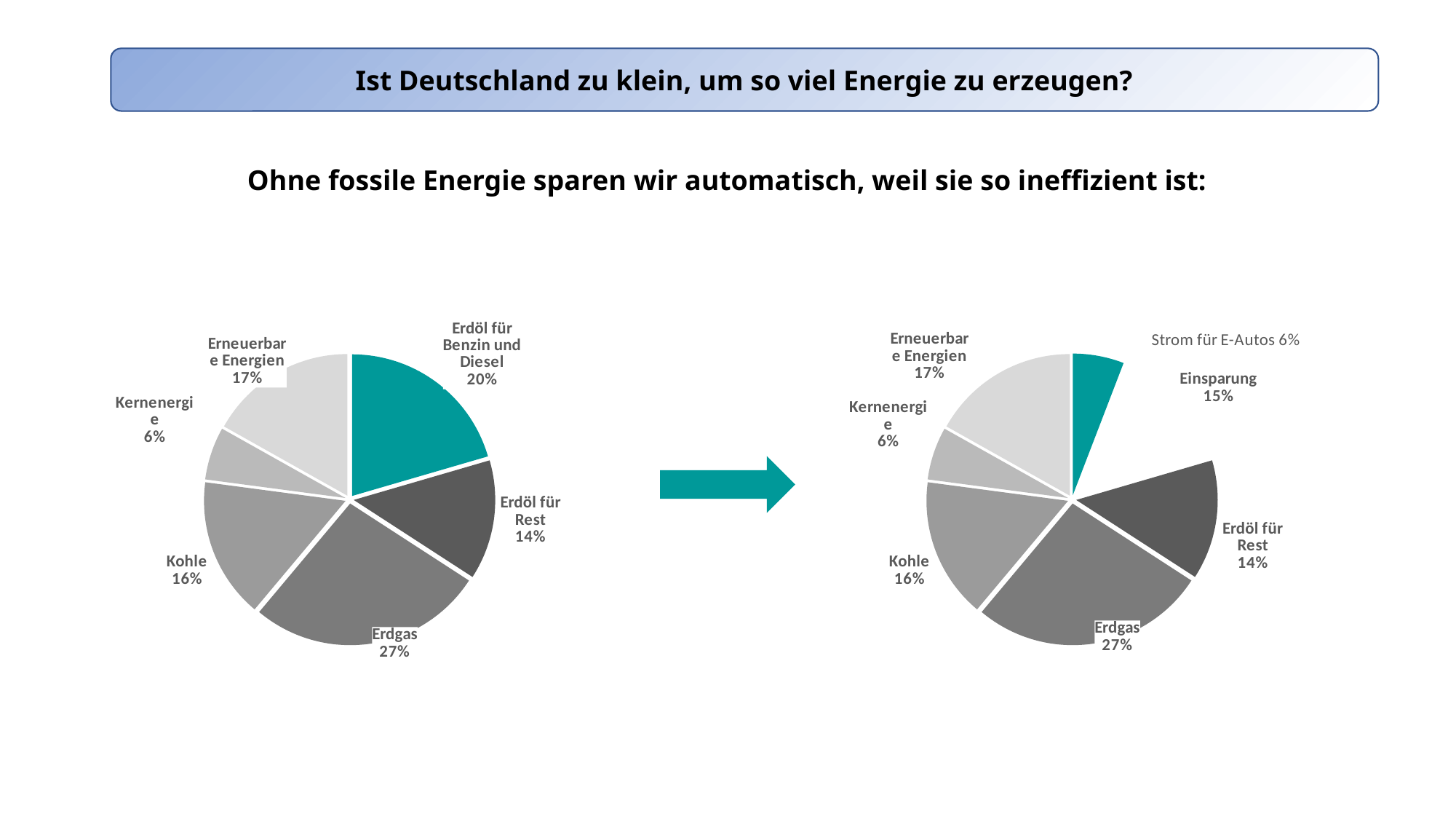
In the left pie chart, what is the difference between the shares of Erdöl für Benzin und Diesel and Erdöl für Rest? 6% In the left pie chart, how many categories are shown? 6 In the right pie chart, how many labelled categories are shown? 7 In the left pie chart, which slice is coloured teal? Erdöl für Benzin und Diesel In the left pie chart, which category has the smallest share? Kernenergie In the left pie chart, which category has the largest share? Erdgas What kind of charts are shown on the slide? Pie charts In the right pie chart, what share does Strom für E-Autos have? 6% In the left pie chart, what share does Erdöl für Benzin und Diesel have? 20% In the right pie chart, which is larger, Kohle or Erneuerbare Energien? Erneuerbare Energien In the right pie chart, what share does Einsparung have? 15% In the left pie chart, what share does Erdgas have? 27%